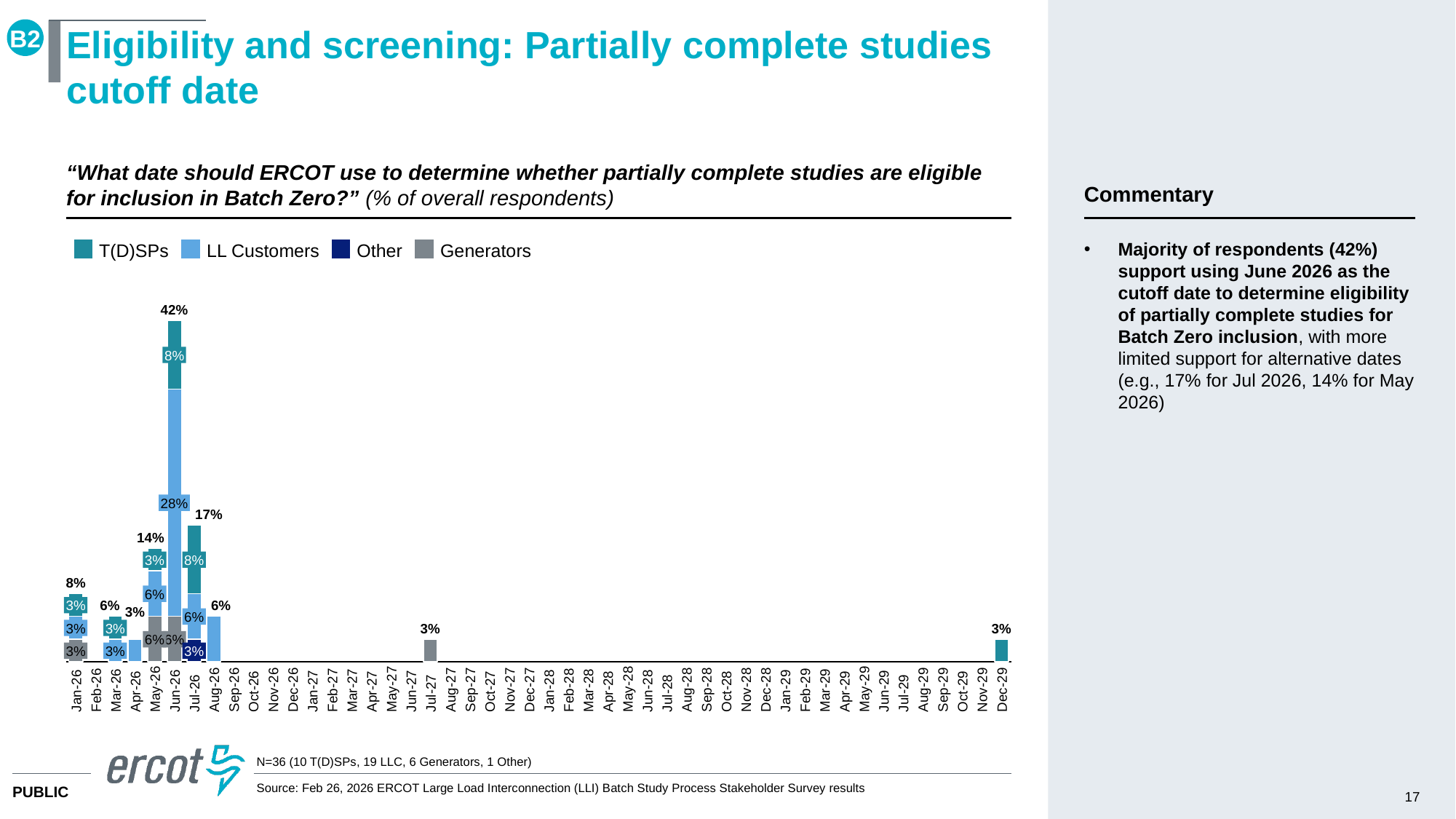
What kind of chart is shown on the slide? Stacked bar chart How many series does the legend list? 4 What is the total percentage of respondents for Jul-27? 3% What is the total percentage of respondents for May-26? 14% Which colour represents Generators in the legend? Gray What percentage do LL Customers contribute to the Jun-26 bar? 28% What is the difference between the Jun-26 total (42%) and the Jul-26 total (17%)? 25 percentage points Which month has the highest overall share of respondents? Jun-26 Which has a larger total share of respondents, May-26 or Jul-26? Jul-26 What is the total percentage of respondents for Jun-26? 42% What is the total percentage of respondents for Jul-26? 17% What percentage do T(D)SPs contribute to the Jul-26 bar? 8%